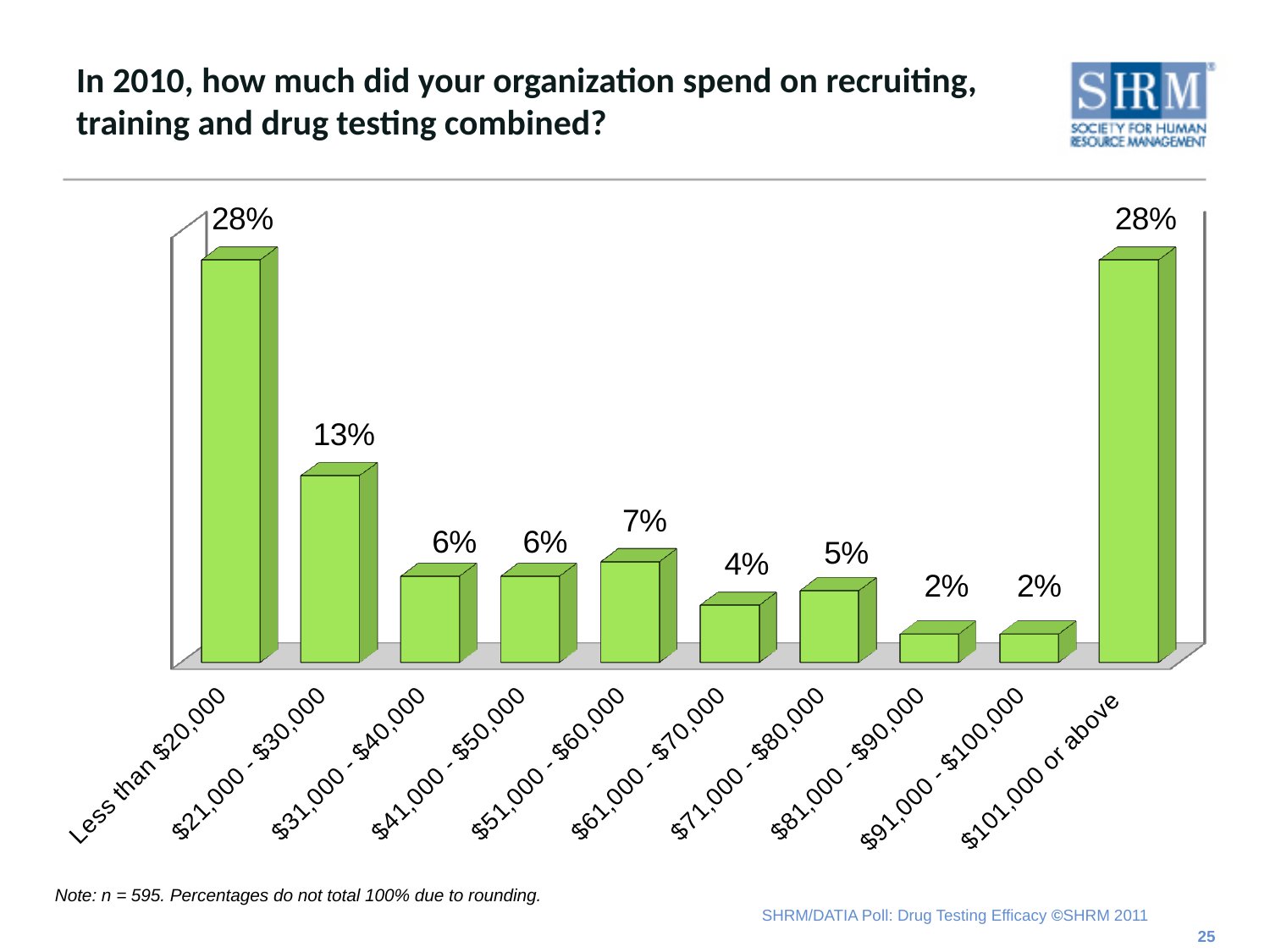
According to the note, what is the sample size (n) for this chart? 595 What is the value for the $101,000 or above category? 28% What is the value for the $51,000 - $60,000 category? 7% What is the highest percentage shown on the chart? 28% What percentage of organizations spent $21,000 - $30,000? 13% What is the difference between the $21,000 - $30,000 value and the $31,000 - $40,000 value? 7% What percentage of organizations spent less than $20,000? 28% What is the lowest percentage shown on the chart? 2% Which is larger, the value for $71,000 - $80,000 or the value for $81,000 - $90,000? $71,000 - $80,000 What kind of chart is shown on the slide? Bar chart What is the value for the $61,000 - $70,000 category? 4% How many spending categories are shown on the chart? 10